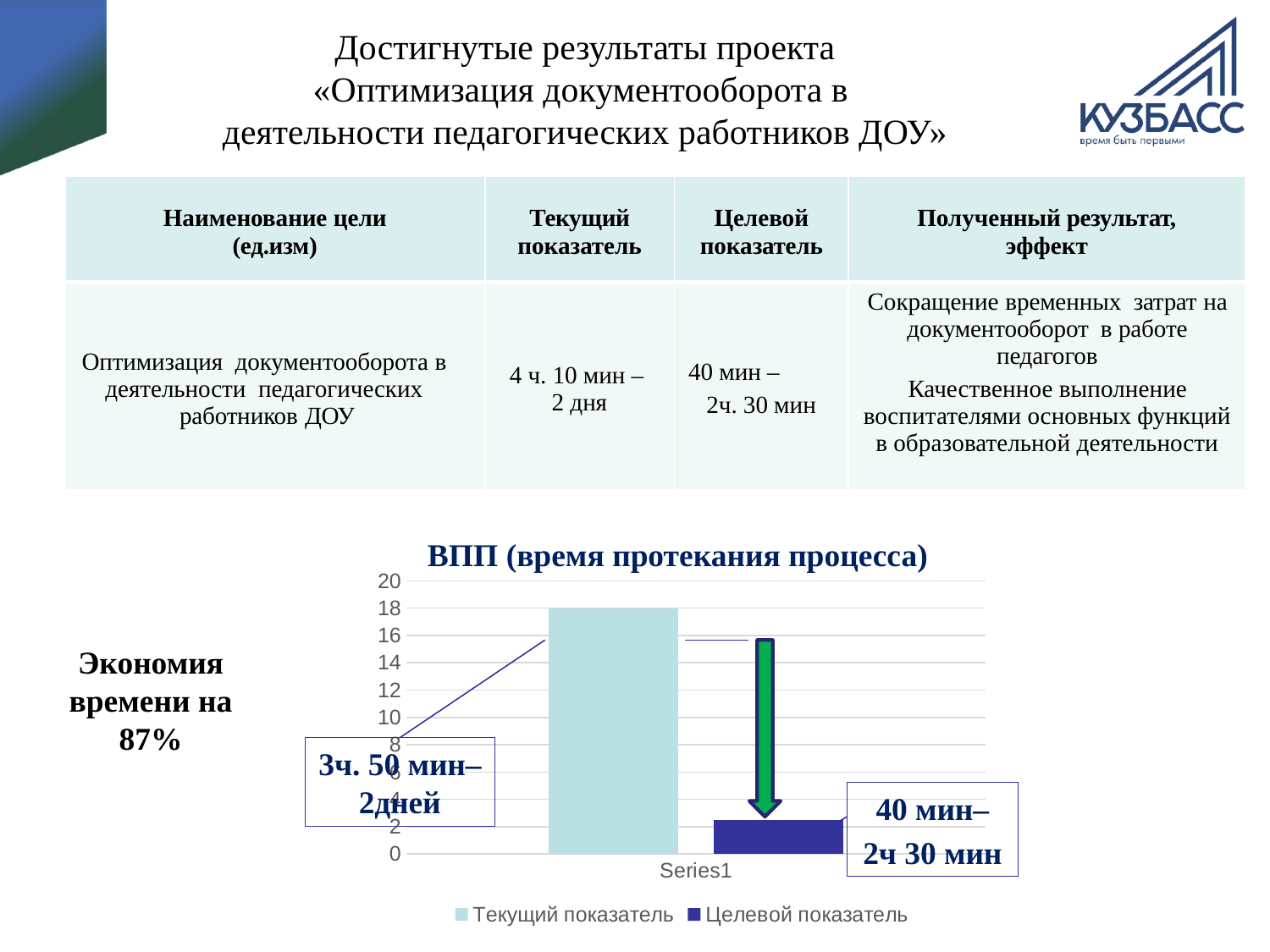
How many categories are shown on the x axis of the chart? 1 Which series has the taller bar in the chart? Текущий показатель Which series has the shorter bar in the chart? Целевой показатель What is the category label shown on the x axis of the chart? Series1 What is the highest value shown on the chart's vertical axis? 20 Which is larger: the bar for Текущий показатель or the bar for Целевой показатель? Текущий показатель How many series does the chart legend list? 2 What is the title of the chart? ВПП (время протекания процесса) Is the bar for Текущий показатель greater or less than 10? greater What kind of chart is shown on the slide? bar chart Is the bar for Целевой показатель greater or less than 4? less